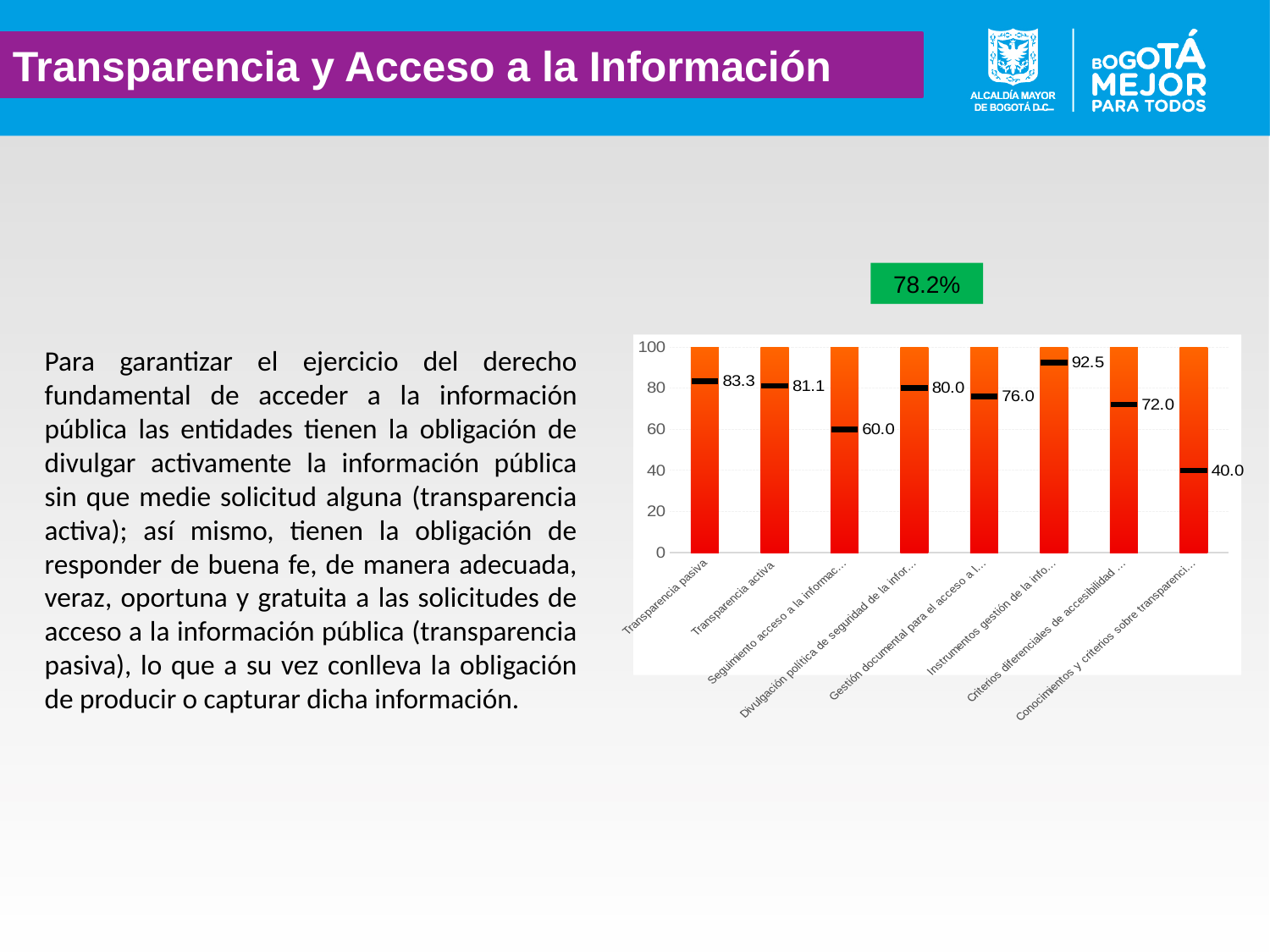
What is the labelled value for Transparencia pasiva? 83.3 What kind of chart is shown on the slide? Bar chart What is the labelled value for the third category from the left (Seguimiento acceso a la informac...)? 60.0 What is the highest value shown on the vertical axis? 100 Which category has the highest labelled value? Instrumentos gestión de la info... (92.5) How many categories are plotted on the chart? 8 What is the labelled value for the last category on the right (Conocimientos y criterios sobre transparenci...)? 40.0 Which category has the lowest labelled value? Conocimientos y criterios sobre transparenci... (40.0) Which has the larger labelled value, Transparencia pasiva or Transparencia activa? Transparencia pasiva What is the difference between the labelled values for Transparencia pasiva and Transparencia activa? 2.2 What is the labelled value for Transparencia activa? 81.1 What percentage is shown in the green box above the chart? 78.2%